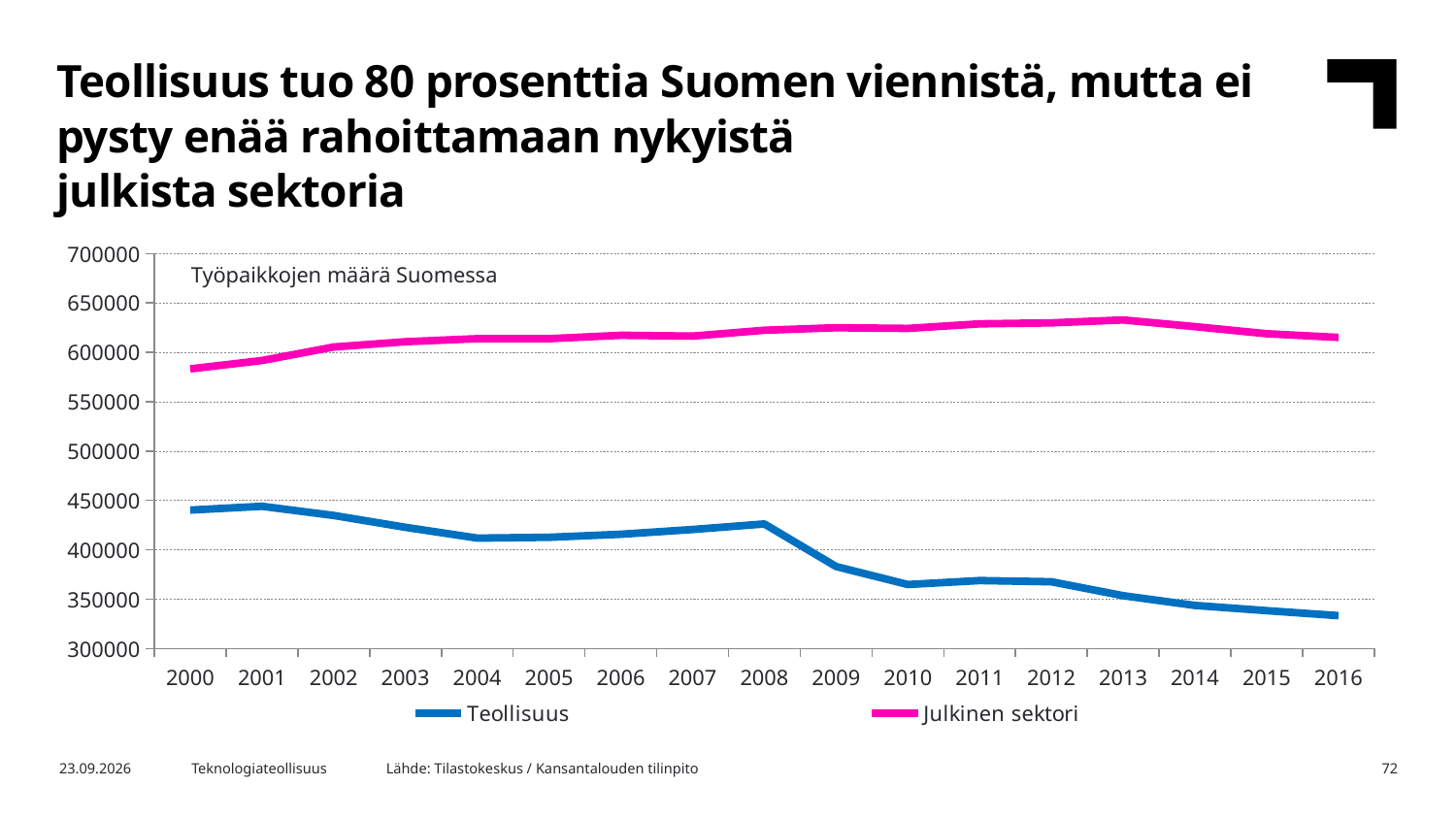
What is the title printed inside the chart area? Työpaikkojen määrä Suomessa Is the value for Julkinen sektori in 2000 greater or less than 550000? greater Does the Teollisuus line rise or fall overall from 2000 to 2016? Fall How many series does the legend list? 2 Does the Julkinen sektori line rise or fall between 2000 and 2008? Rise Which series is drawn in pink? Julkinen sektori What kind of chart is shown on the slide? Line chart Is the value for Teollisuus in 2016 greater or less than 350000? less In which year is the Teollisuus line at its lowest? 2016 Is the value for Teollisuus in 2008 greater or less than 400000? greater In which year is the Julkinen sektori line at its lowest? 2000 How many years are plotted along the x axis? 17